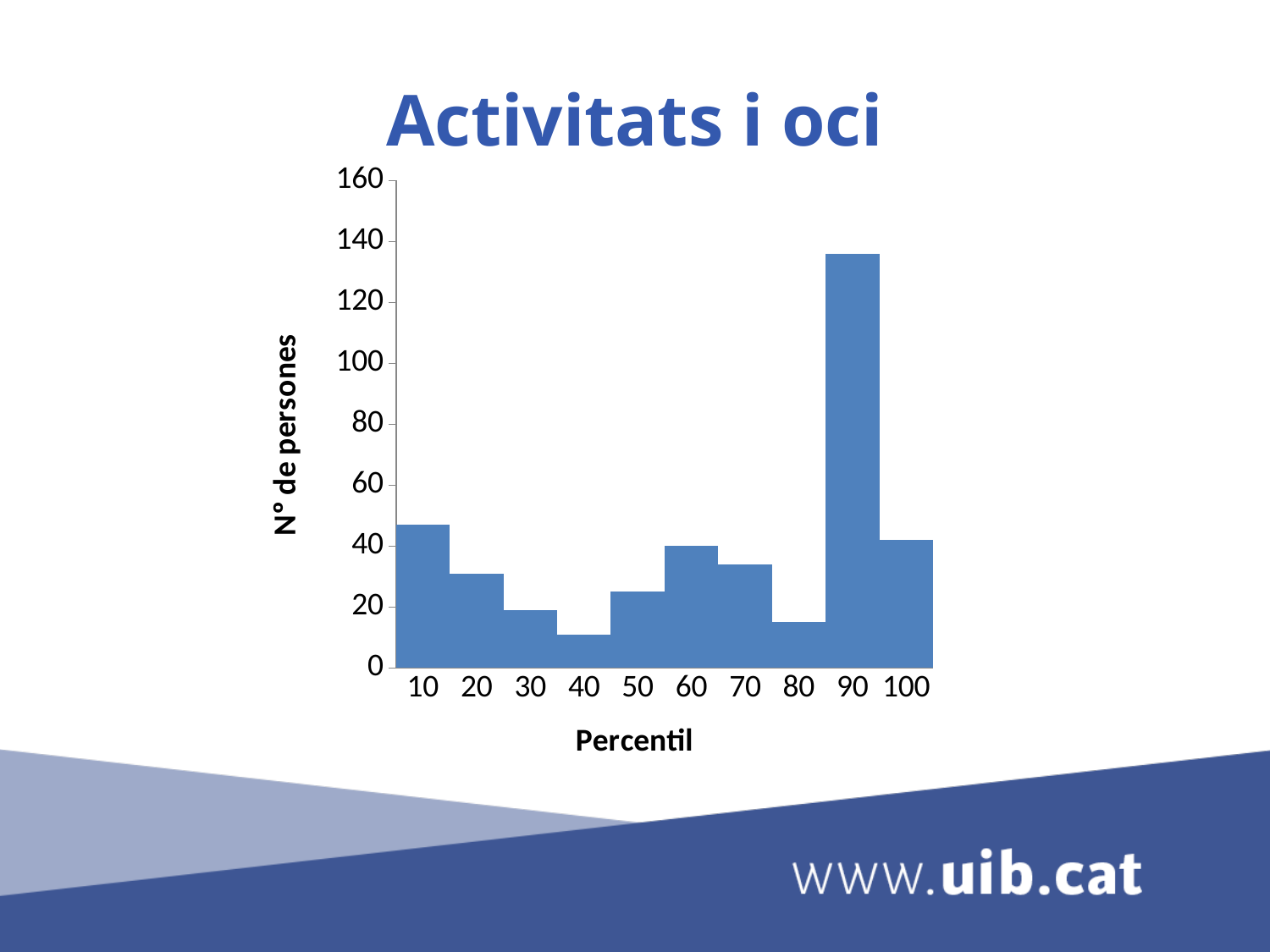
What is the title of the chart? Activitats i oci How many bars (percentile categories) are plotted in the chart? 10 Is the value for percentile 10 greater or less than 60? less What is the label of the vertical axis? Nº de persones Is the value for percentile 60 greater or less than 60? less What kind of chart is shown on the slide? bar chart Which has more people, percentile 10 or percentile 20? 10 Which percentile has the highest number of people? 90 Is the value for percentile 80 greater or less than 20? less Which has more people, percentile 90 or percentile 100? 90